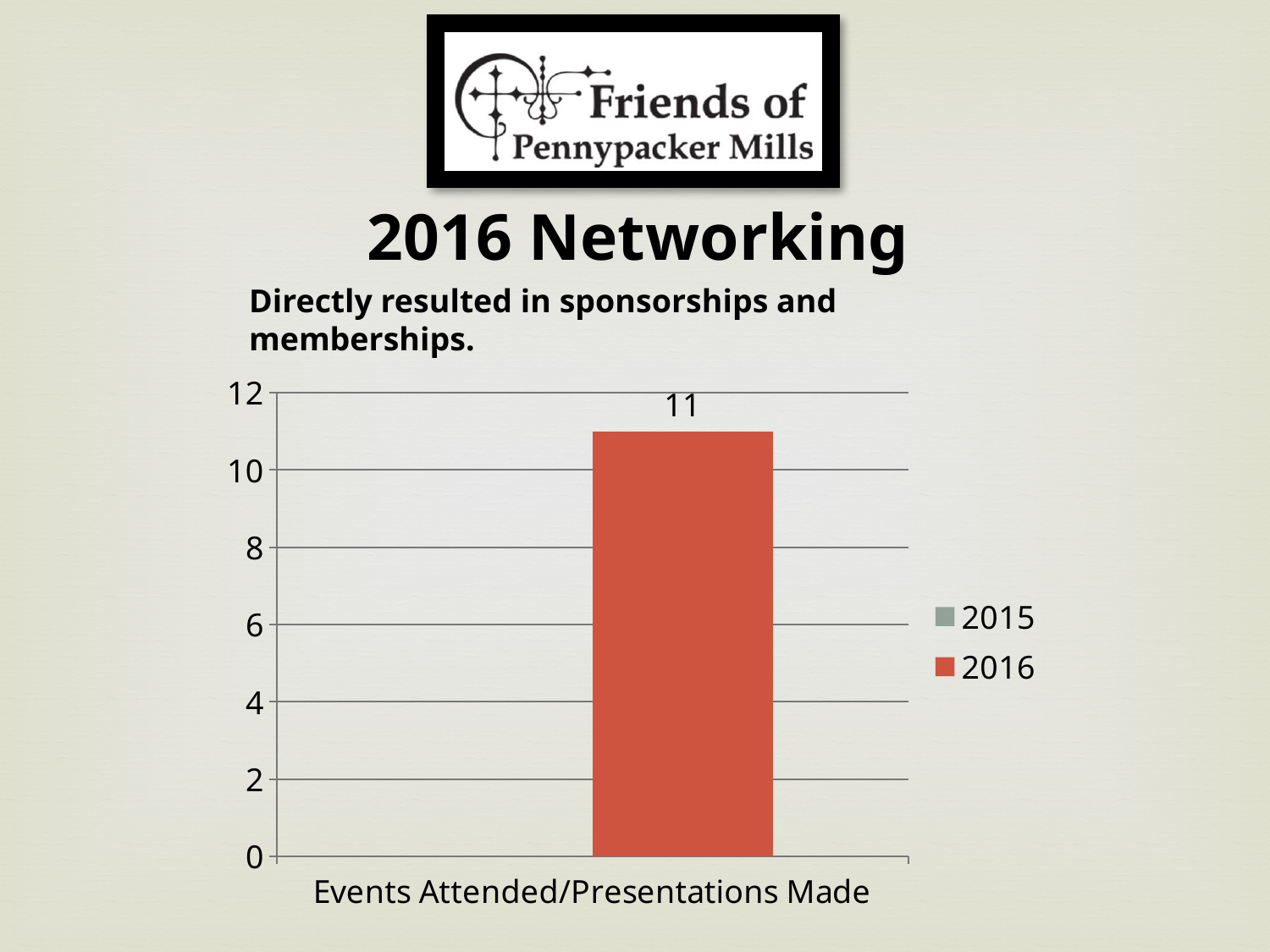
What is the category label on the x axis? Events Attended/Presentations Made What kind of chart is shown on the slide? bar chart How many series does the legend list? 2 Which series is shown in red in the legend? 2016 Is the value for 2016 for Events Attended/Presentations Made greater or less than 10? greater How many categories are shown on the x axis? 1 What is the highest value shown on the y axis? 12 Is the value for 2016 for Events Attended/Presentations Made greater or less than 12? less What is the value for 2016 for Events Attended/Presentations Made? 11